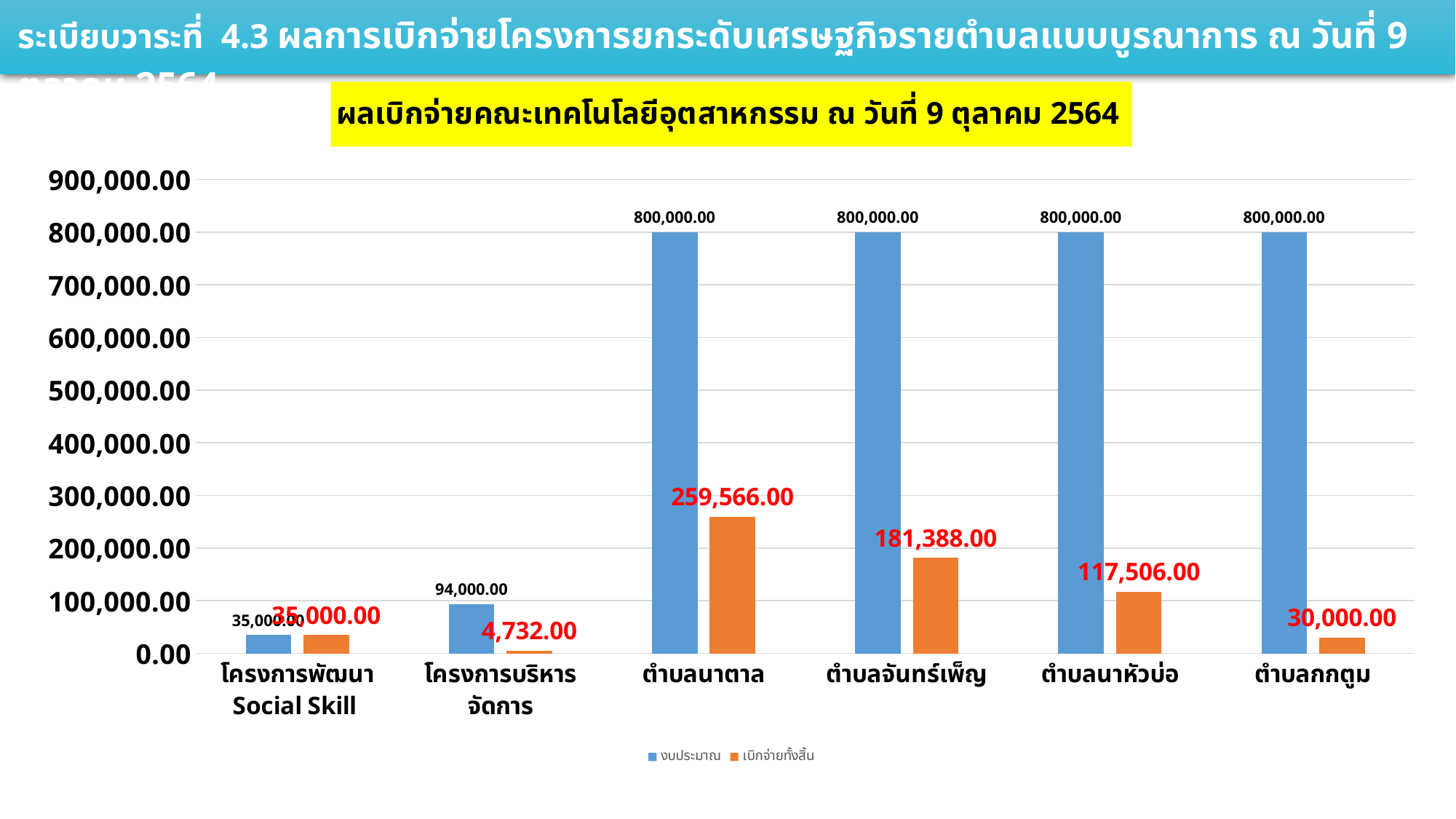
Which category has the lowest เบิกจ่ายทั้งสิ้น value? โครงการบริหารจัดการ What colour are the bars for the เบิกจ่ายทั้งสิ้น series? orange How many categories are shown on the x axis of the chart? 6 What is the difference between the งบประมาณ and เบิกจ่ายทั้งสิ้น values for ตำบลจันทร์เพ็ญ? 618,612.00 How many series does the legend list? 2 What type of chart is shown on the slide? bar chart Which category has the highest เบิกจ่ายทั้งสิ้น value? ตำบลนาตาล Which is larger, the เบิกจ่ายทั้งสิ้น value for ตำบลนาหัวบ่อ or for ตำบลกกตูม? ตำบลนาหัวบ่อ What is the เบิกจ่ายทั้งสิ้น value for ตำบลกกตูม? 30,000.00 What is the งบประมาณ value for โครงการบริหารจัดการ? 94,000.00 What is the เบิกจ่ายทั้งสิ้น value for ตำบลนาตาล? 259,566.00 Is the เบิกจ่ายทั้งสิ้น value for ตำบลนาตาล greater or less than 200,000.00? greater